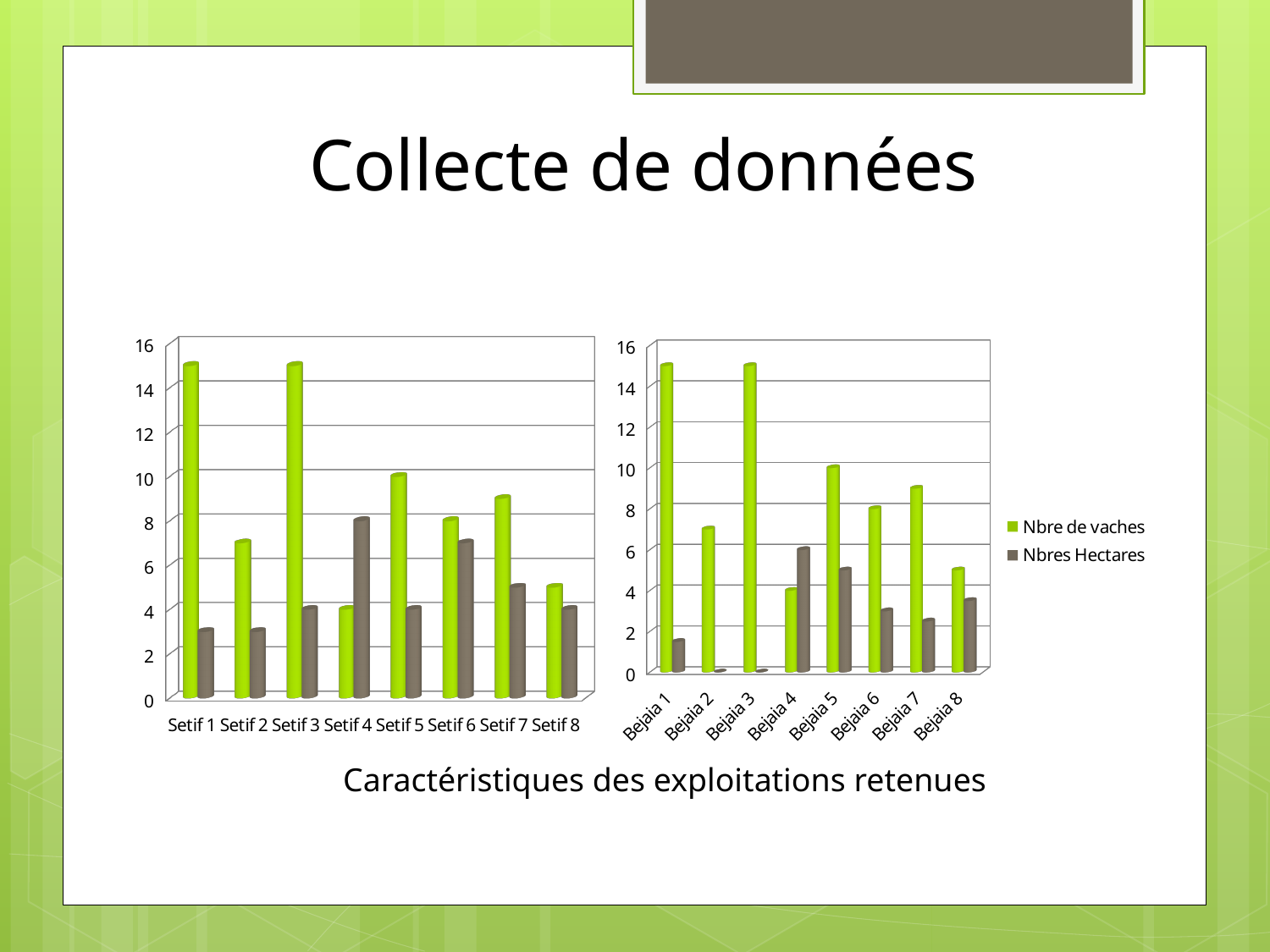
On the right chart (Bejaia), which category has the highest value for Nbres Hectares? Bejaia 4 On the left chart (Setif), how many categories are shown on the x axis? 8 On the right chart (Bejaia), is the Nbres Hectares value for Bejaia 2 greater or less than 2? less On the left chart (Setif), is the green (Nbre de vaches) value for Setif 1 greater or less than 14? greater On the left chart (Setif), is the grey (Nbres Hectares) value for Setif 4 greater or less than 6? greater On the left chart (Setif), which category has the highest grey (Nbres Hectares) bar? Setif 4 What kind of chart is the right chart (Bejaia)? bar chart On the right chart (Bejaia), how many series does the legend list? 2 On the right chart (Bejaia), for Bejaia 1, which series has the larger value: Nbre de vaches or Nbres Hectares? Nbre de vaches What is the caption written below the two charts? Caractéristiques des exploitations retenues On the right chart (Bejaia), for Bejaia 4, which series has the larger value: Nbre de vaches or Nbres Hectares? Nbres Hectares